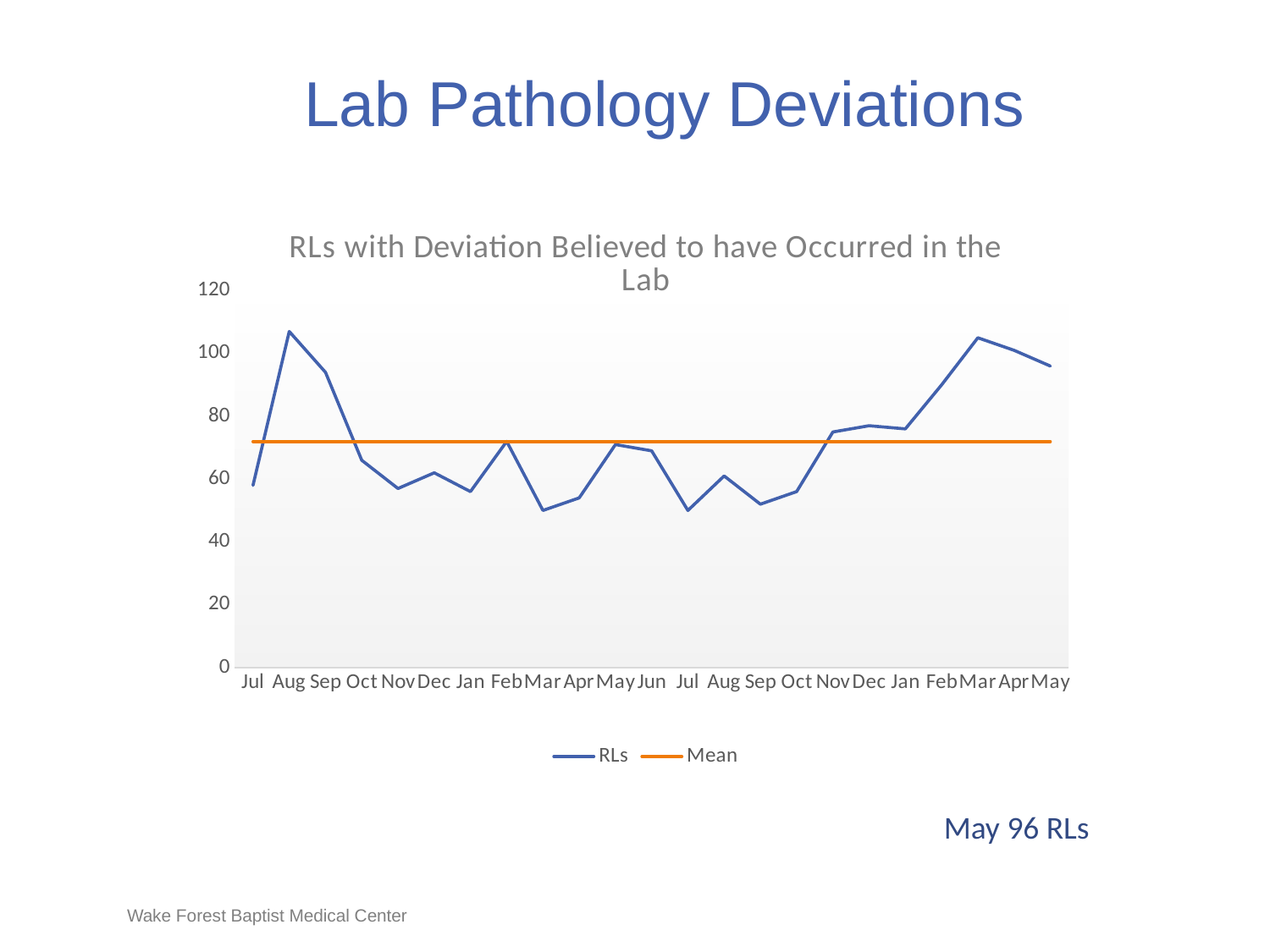
What is the title of the chart? RLs with Deviation Believed to have Occurred in the Lab What kind of chart is shown on the slide? Line chart Is the RLs value for the first Nov on the x axis greater or less than 60? less According to the text below the chart, how many RLs were there in the final May? 96 RLs Which has the larger RLs value, the first Aug or the first Oct on the x axis? Aug How many series does the chart legend list? 2 How many monthly points are plotted along the x axis of the chart? 23 Do the RLs values rise or fall from the first Jul to the first Aug on the x axis? Rise Is the RLs value for the second Feb on the x axis greater or less than 80? greater Is the Mean line greater or less than 80? less What colour is the Mean line in the chart? Orange